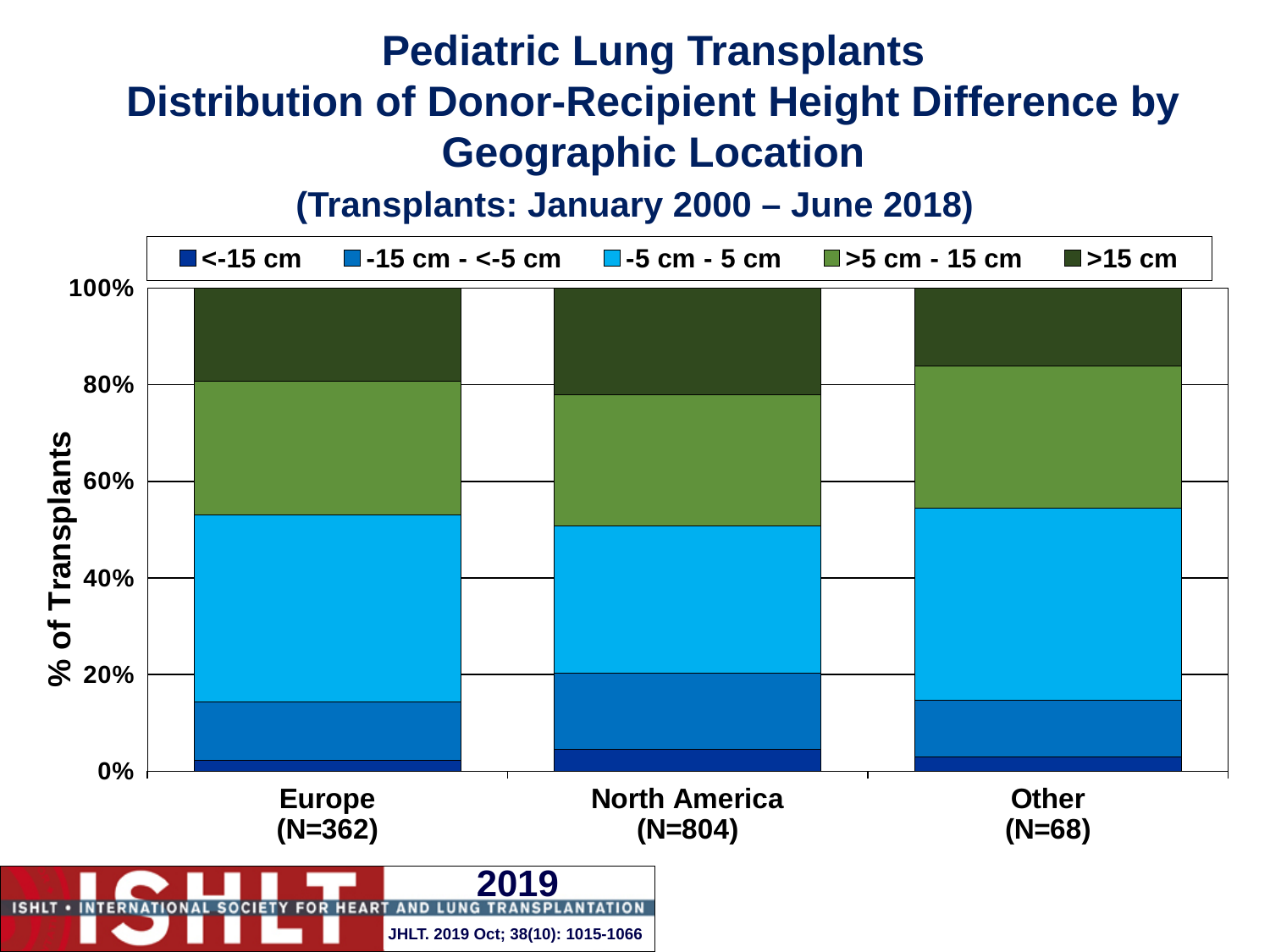
What is the sample size (N) shown for Europe? N=362 What is the sample size (N) shown for Other? N=68 Which geographic location has the largest share of transplants in the <-15 cm height difference category? North America How many geographic location categories are shown on the x axis? 3 Which geographic location has the largest sample size (N)? North America What is the label of the y axis? % of Transplants Is the share of the -5 cm - 5 cm segment for North America greater or less than 20%? greater What kind of chart is shown on the slide? Stacked bar chart What is the sample size (N) shown for North America? N=804 Which geographic location has the largest share of transplants in the >15 cm height difference category? North America How many series does the legend list? 5 Is the share of the -15 cm - <-5 cm segment for Other greater or less than 20%? less